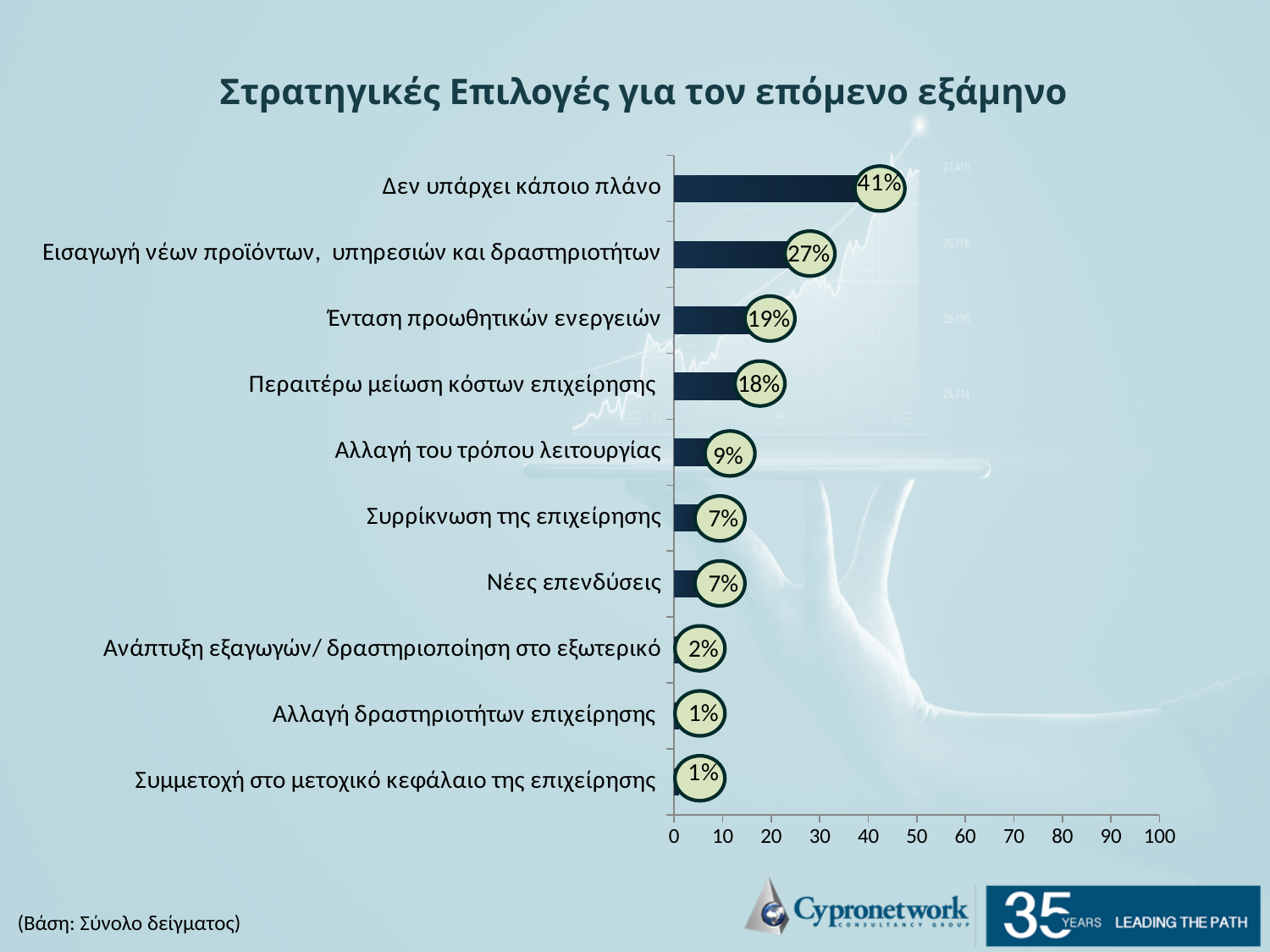
What is the value for "Ανάπτυξη εξαγωγών/ δραστηριοποίηση στο εξωτερικό"? 2% Is the value for "Εισαγωγή νέων προϊόντων, υπηρεσιών και δραστηριοτήτων" greater or less than 20? greater Which category has the highest value? Δεν υπάρχει κάποιο πλάνο What is the value for "Αλλαγή του τρόπου λειτουργίας"? 9% What is the maximum value shown on the horizontal axis? 100 What is the value for "Δεν υπάρχει κάποιο πλάνο"? 41% How many categories are shown in the chart? 10 What kind of chart is shown on the slide? Bar chart Which is larger: "Περαιτέρω μείωση κόστων επιχείρησης" or "Αλλαγή του τρόπου λειτουργίας"? Περαιτέρω μείωση κόστων επιχείρησης What is the difference between "Δεν υπάρχει κάποιο πλάνο" and "Εισαγωγή νέων προϊόντων, υπηρεσιών και δραστηριοτήτων"? 14% What is the value for "Ένταση προωθητικών ενεργειών"? 19% What is the title of the chart? Στρατηγικές Επιλογές για τον επόμενο εξάμηνο